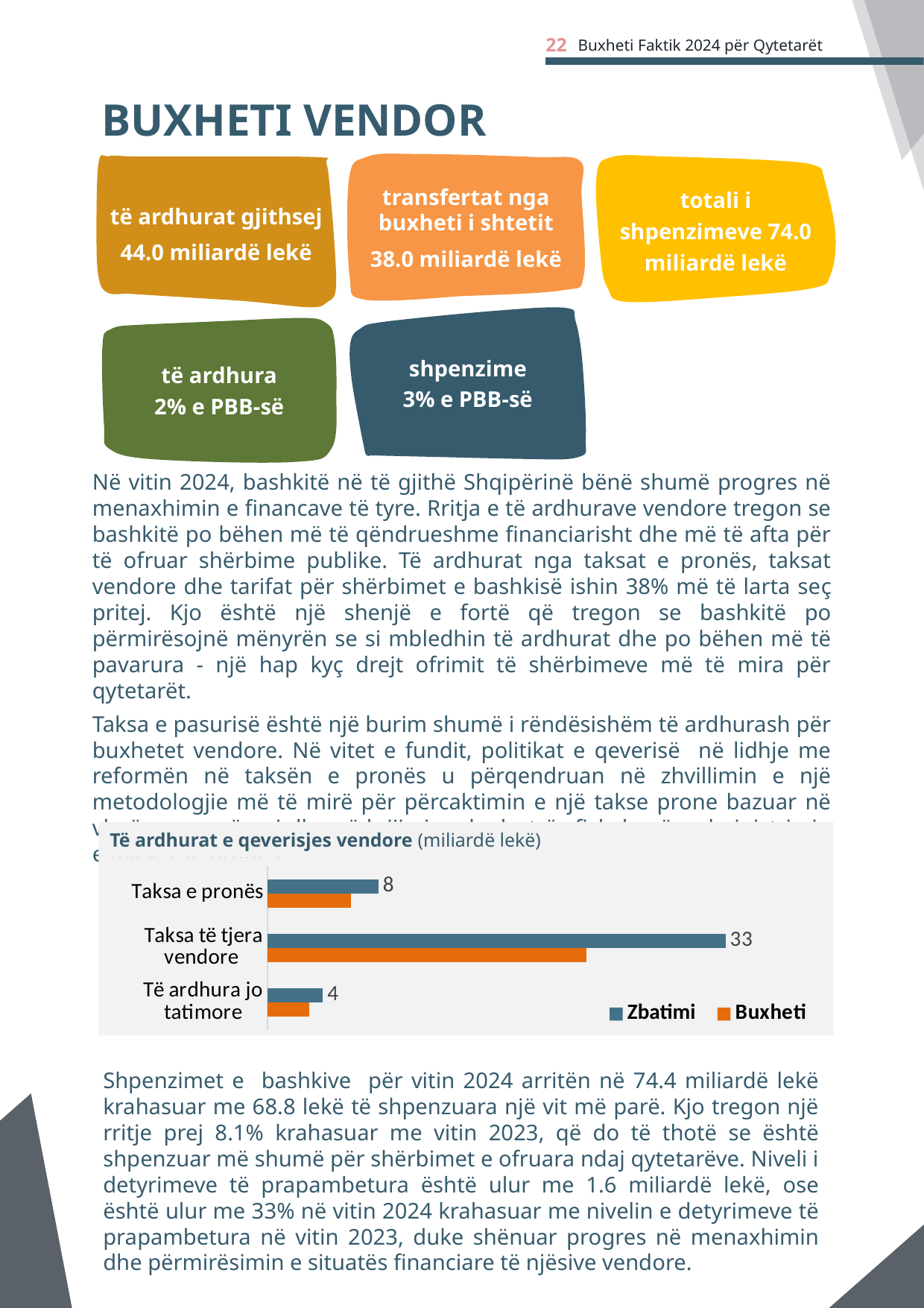
What is the Zbatimi value for Taksa të tjera vendore? 33 How many categories are shown in the chart? 3 Which category has the lowest Zbatimi value? Të ardhura jo tatimore What is the difference between the Zbatimi values for Taksa e pronës and Të ardhura jo tatimore? 4 What is the difference between the Zbatimi values for Taksa të tjera vendore and Taksa e pronës? 25 For Taksa e pronës, which series has the larger value, Zbatimi or Buxheti? Zbatimi For Taksa të tjera vendore, which series has the larger value, Zbatimi or Buxheti? Zbatimi What is the Zbatimi value for Taksa e pronës? 8 Which category has the highest Zbatimi value? Taksa të tjera vendore What is the Zbatimi value for Të ardhura jo tatimore? 4 How many series does the legend list? 2 What kind of chart is shown on the slide? Bar chart